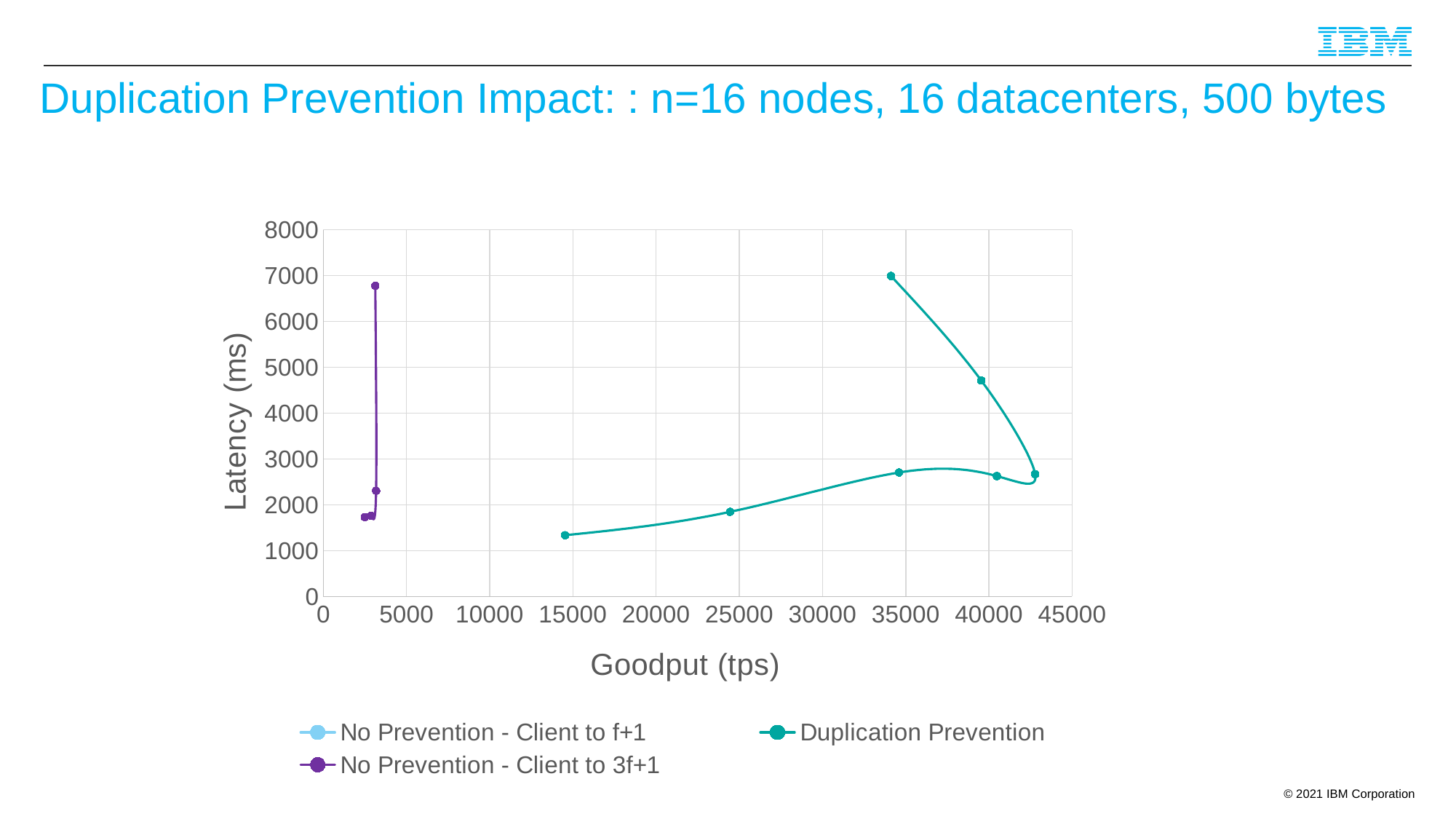
What is the label of the y axis? Latency (ms) Is the lowest latency of the Duplication Prevention series greater or less than 1500 ms? less Is the highest latency reached by the Duplication Prevention series greater or less than 6000 ms? greater Is the maximum goodput reached by the Duplication Prevention series greater or less than 40000 tps? greater Which series reaches a higher goodput, Duplication Prevention or No Prevention - Client to 3f+1? Duplication Prevention How many data points are plotted for the No Prevention - Client to 3f+1 series? 4 What is the label of the x axis? Goodput (tps) How many series does the legend list? 3 What kind of chart is shown on the slide? line chart How many data points are plotted for the Duplication Prevention series? 7